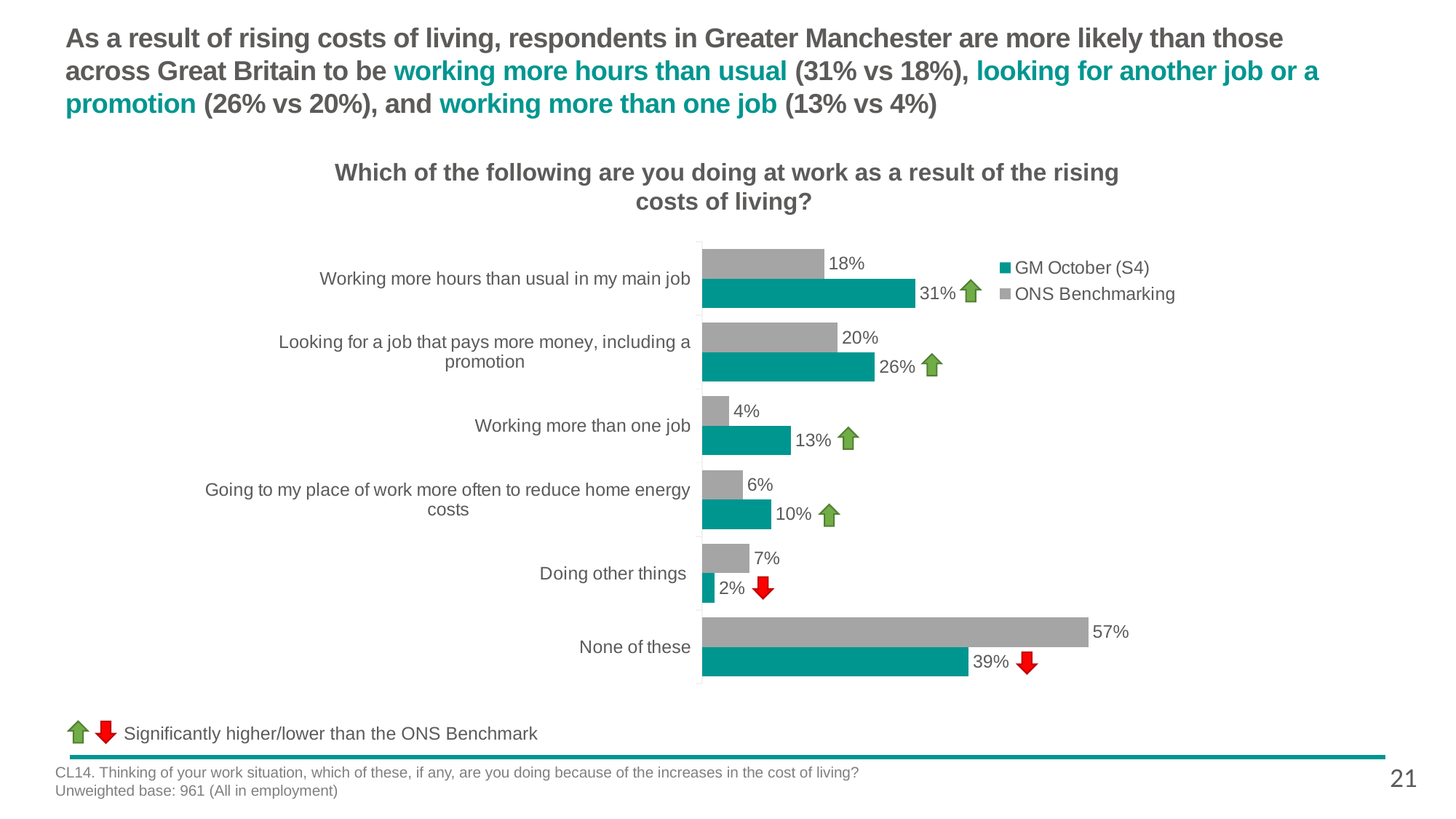
How many series does the legend list? 2 For 'Going to my place of work more often to reduce home energy costs', which series has the larger value? GM October (S4) Which category has the highest ONS Benchmarking value? None of these What kind of chart is shown on the slide? Bar chart What is the difference between the ONS Benchmarking and GM October (S4) values for 'None of these'? 18% Which colour represents the ONS Benchmarking series? Grey What is the GM October (S4) value for 'Doing other things'? 2% How many categories are shown in the chart? 6 What is the difference between the GM October (S4) and ONS Benchmarking values for 'Working more than one job'? 9% Which category has the lowest GM October (S4) value? Doing other things What is the ONS Benchmarking value for 'Working more than one job'? 4% What is the GM October (S4) value for 'Working more hours than usual in my main job'? 31%